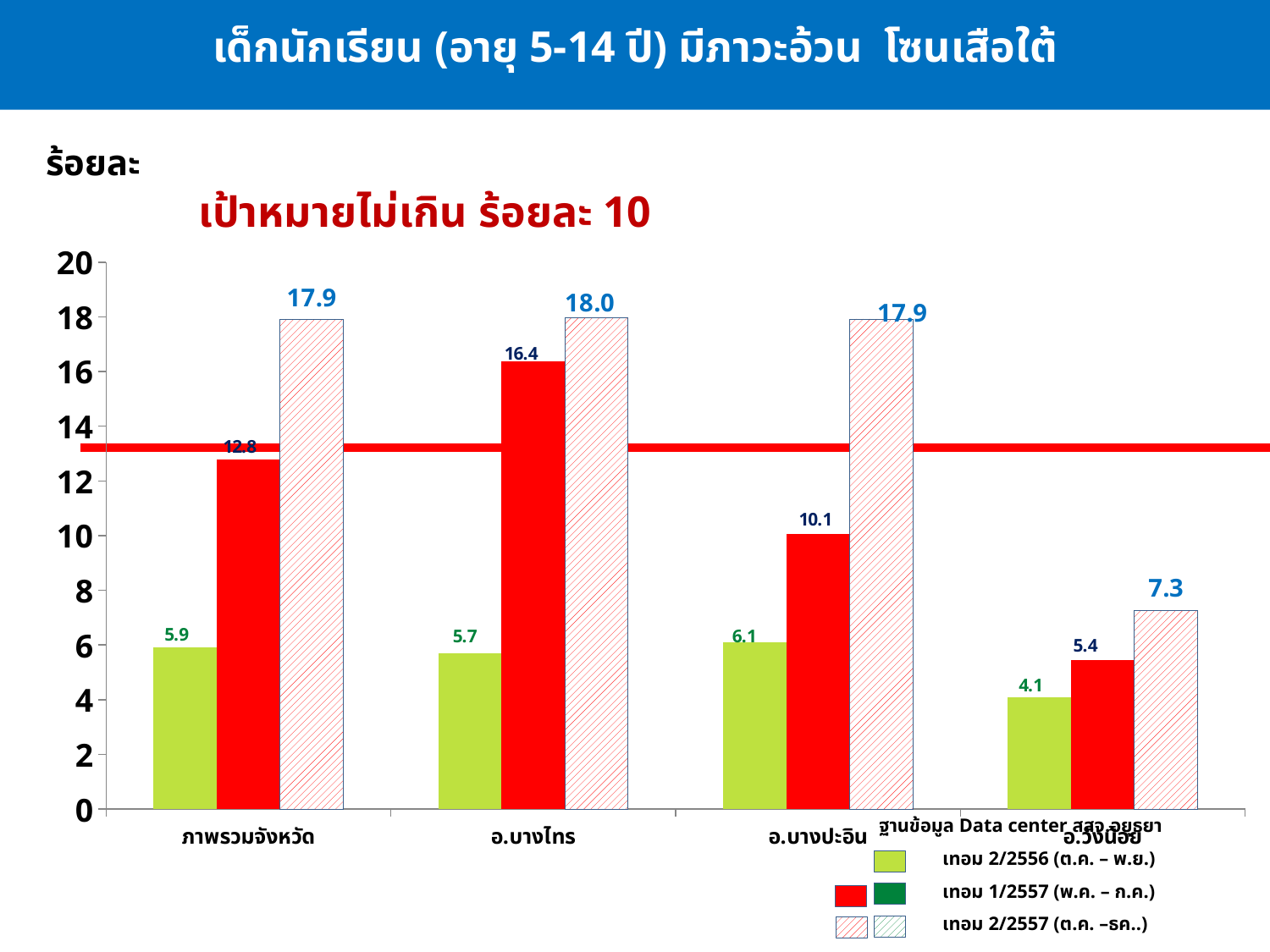
Which category has the lowest value in เทอม 2/2556 (ต.ค. – พ.ย.)? อ.วังน้อย What is the value for อ.บางไทร in เทอม 1/2557 (พ.ค. – ก.ค.)? 16.4 What is the value for อ.บางปะอิน in เทอม 1/2557 (พ.ค. – ก.ค.)? 10.1 How many series does the legend list? 3 What type of chart is shown on the slide? bar chart How many categories are shown on the x axis? 4 Which is larger for อ.บางปะอิน: the เทอม 2/2556 value or the เทอม 1/2557 value? เทอม 1/2557 What is the difference between the เทอม 2/2557 and เทอม 1/2557 values for ภาพรวมจังหวัด? 5.1 What is the value for ภาพรวมจังหวัด in เทอม 2/2556 (ต.ค. – พ.ย.)? 5.9 Which category has the highest value in เทอม 2/2557 (ต.ค. –ธค..)? อ.บางไทร What is the value for อ.วังน้อย in เทอม 2/2557 (ต.ค. –ธค..)? 7.3 What target is stated in the red text above the chart? เป้าหมายไม่เกิน ร้อยละ 10